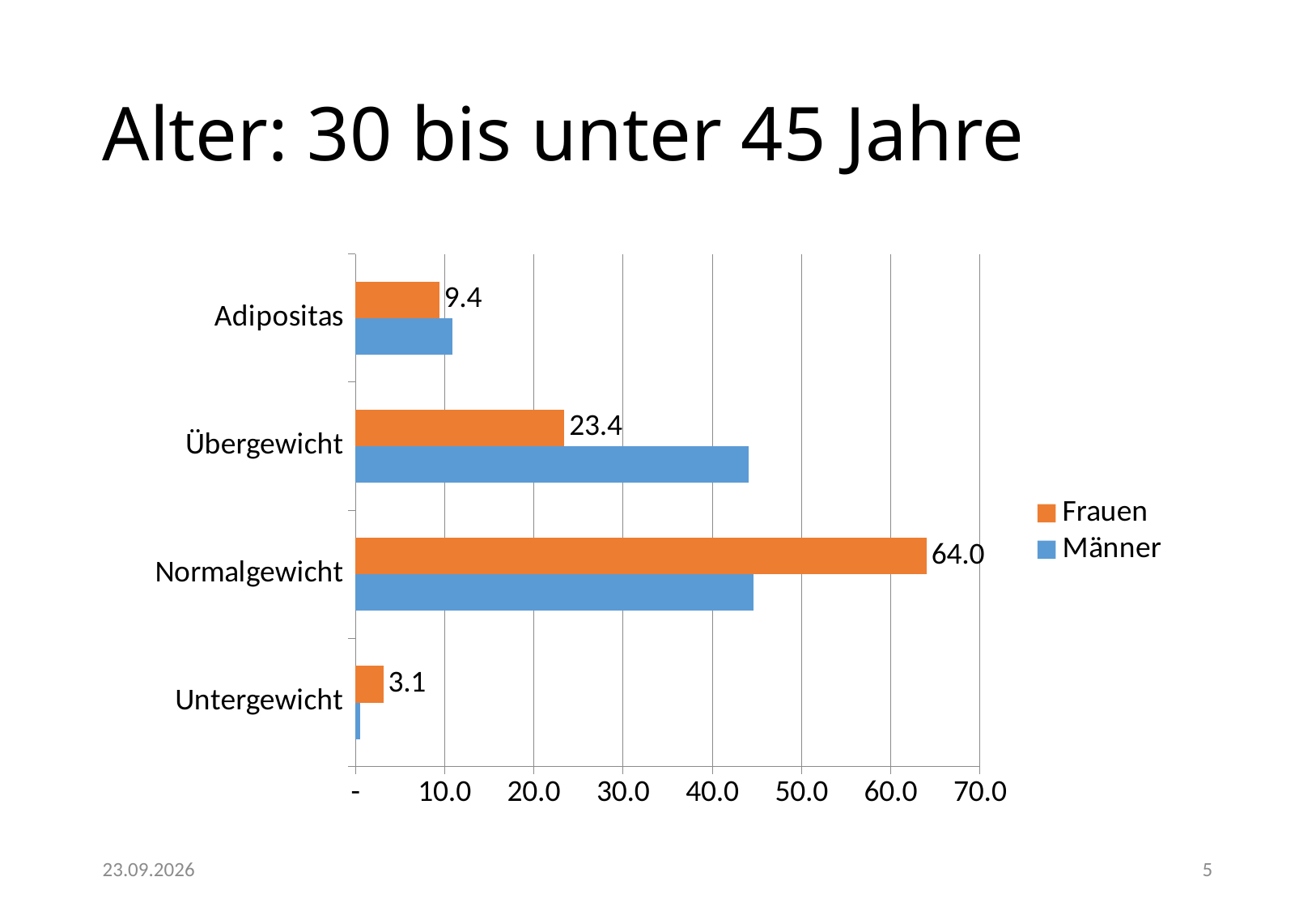
What is the Frauen value for Adipositas? 9.4 How many categories are shown on the chart? 4 What is the Frauen value for Untergewicht? 3.1 What is the Frauen value for Normalgewicht? 64.0 Is the Männer value for Adipositas greater or less than 20.0? less What is the Frauen value for Übergewicht? 23.4 Is the Männer value for Übergewicht greater or less than 40.0? greater Which category has the lowest Frauen value? Untergewicht What is the difference between the Frauen values for Normalgewicht and Übergewicht? 40.6 For Übergewicht, which series has the larger value, Frauen or Männer? Männer How many series does the legend list? 2 Which category has the highest Frauen value? Normalgewicht